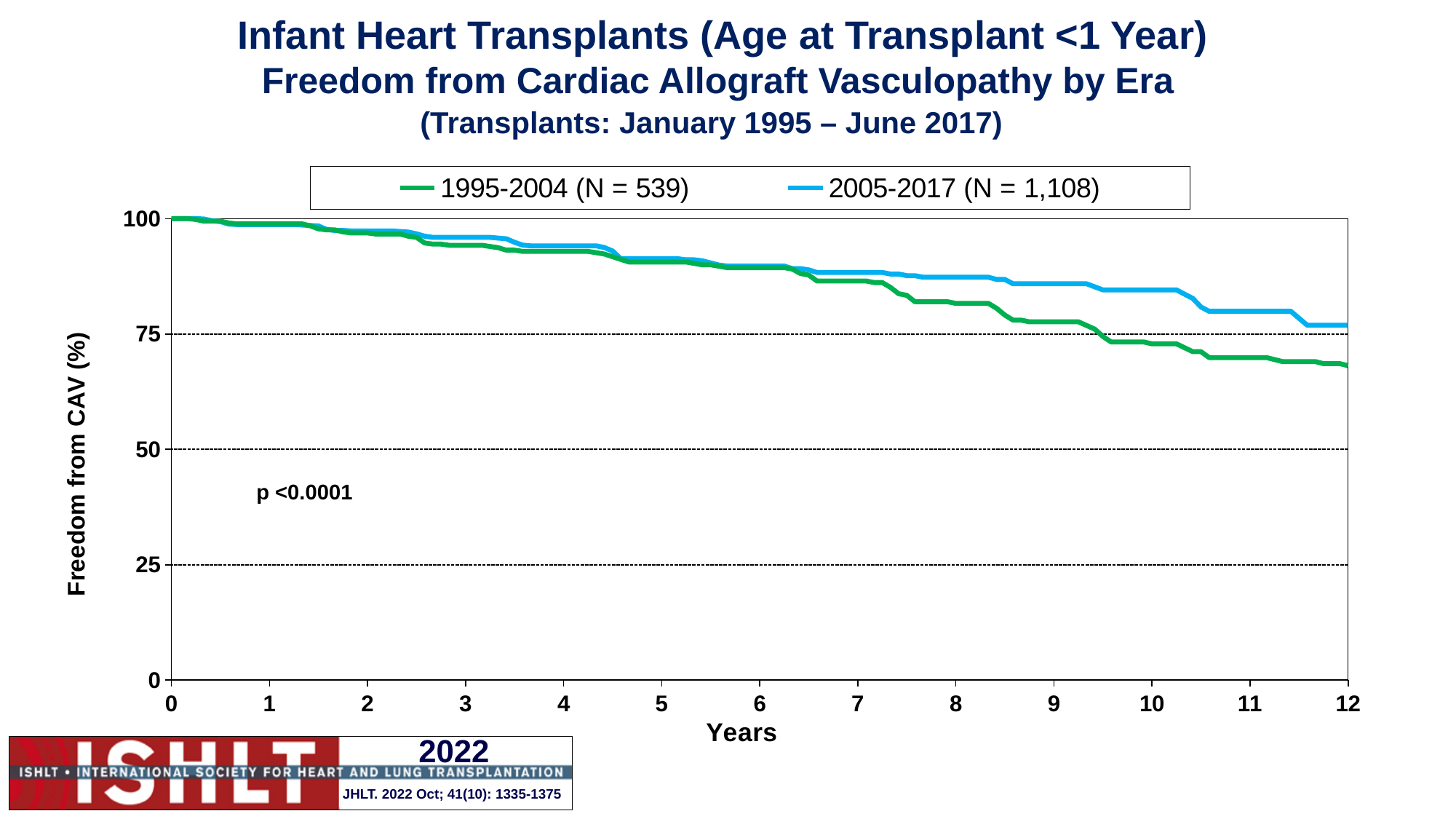
Do the freedom from CAV curves rise or fall as years since transplant increase? Fall What p-value is printed on the chart? p <0.0001 What kind of chart is shown on the slide? Line chart What is the N for the 2005-2017 era shown in the legend? 1,108 At 12 years, which era has the higher freedom from CAV, 1995-2004 or 2005-2017? 2005-2017 How many series does the legend list? 2 What is the label of the y axis? Freedom from CAV (%) What is the N for the 1995-2004 era shown in the legend? 539 Is the freedom from CAV for the 1995-2004 era at 6 years greater or less than 75%? greater Is the freedom from CAV for the 1995-2004 era at 12 years greater or less than 75%? less Which two eras are compared in the legend? 1995-2004 and 2005-2017 Is the freedom from CAV for the 2005-2017 era at 12 years greater or less than 75%? greater